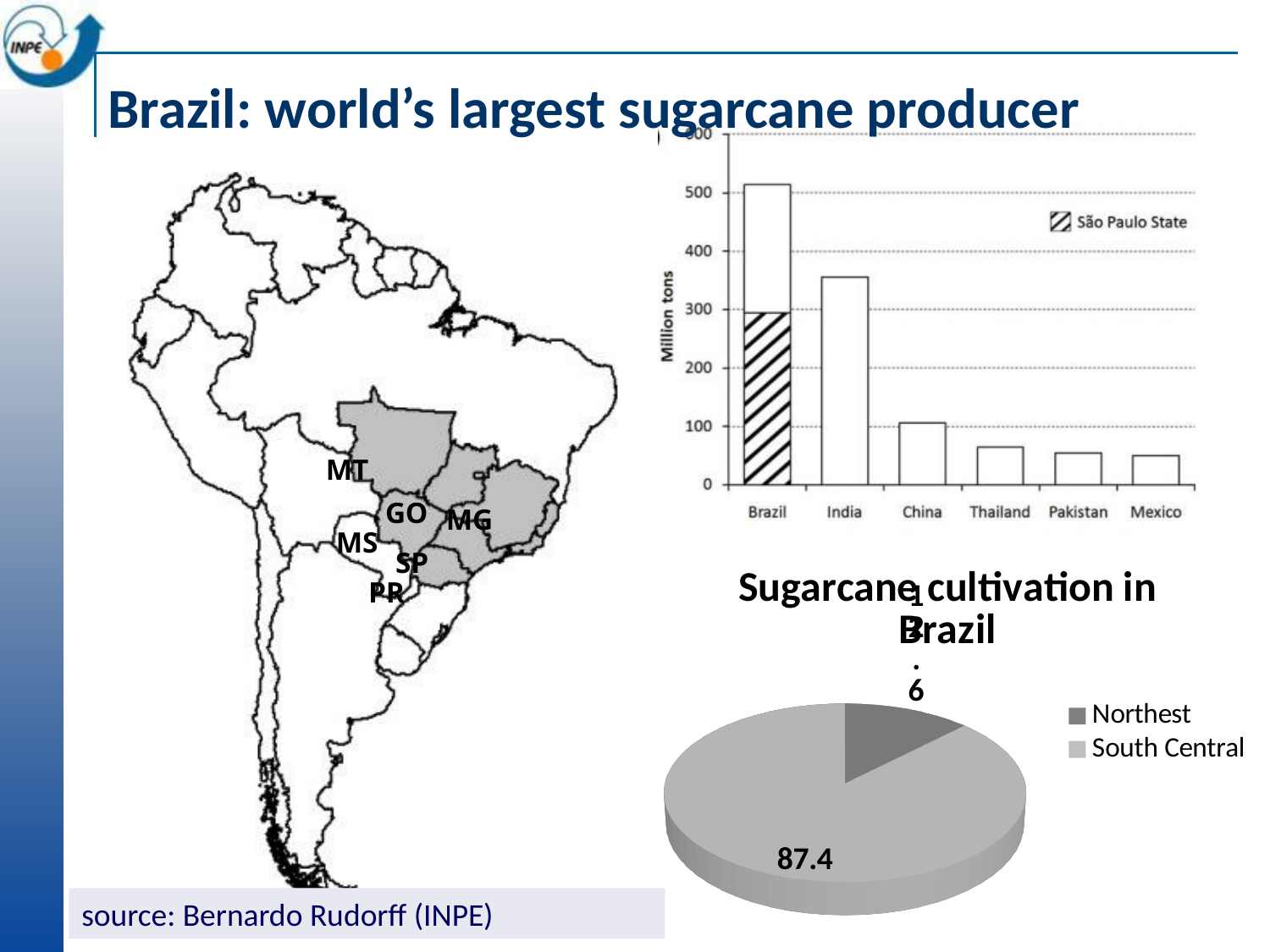
What is the y-axis label of the bar chart at the top right? Million tons In the 'Sugarcane cultivation in Brazil' chart, what is the value for South Central? 87.4 In the bar chart at the top right, which is larger, the value for India or the value for China? India What kind of chart is 'Sugarcane cultivation in Brazil'? pie chart In the bar chart at the top right, is the value for Brazil greater or less than 400? greater In the bar chart at the top right, do the values rise or fall from left to right across the countries? fall In the bar chart at the top right, which country has the highest value? Brazil In the bar chart at the top right, is the value for India greater or less than 400? less What kind of chart is the chart at the top right of the slide showing sugarcane production by country? bar chart How many entries does the legend of the 'Sugarcane cultivation in Brazil' chart list? 2 In the bar chart at the top right, is the value for Thailand greater or less than 100? less How many countries are shown in the bar chart at the top right? 6